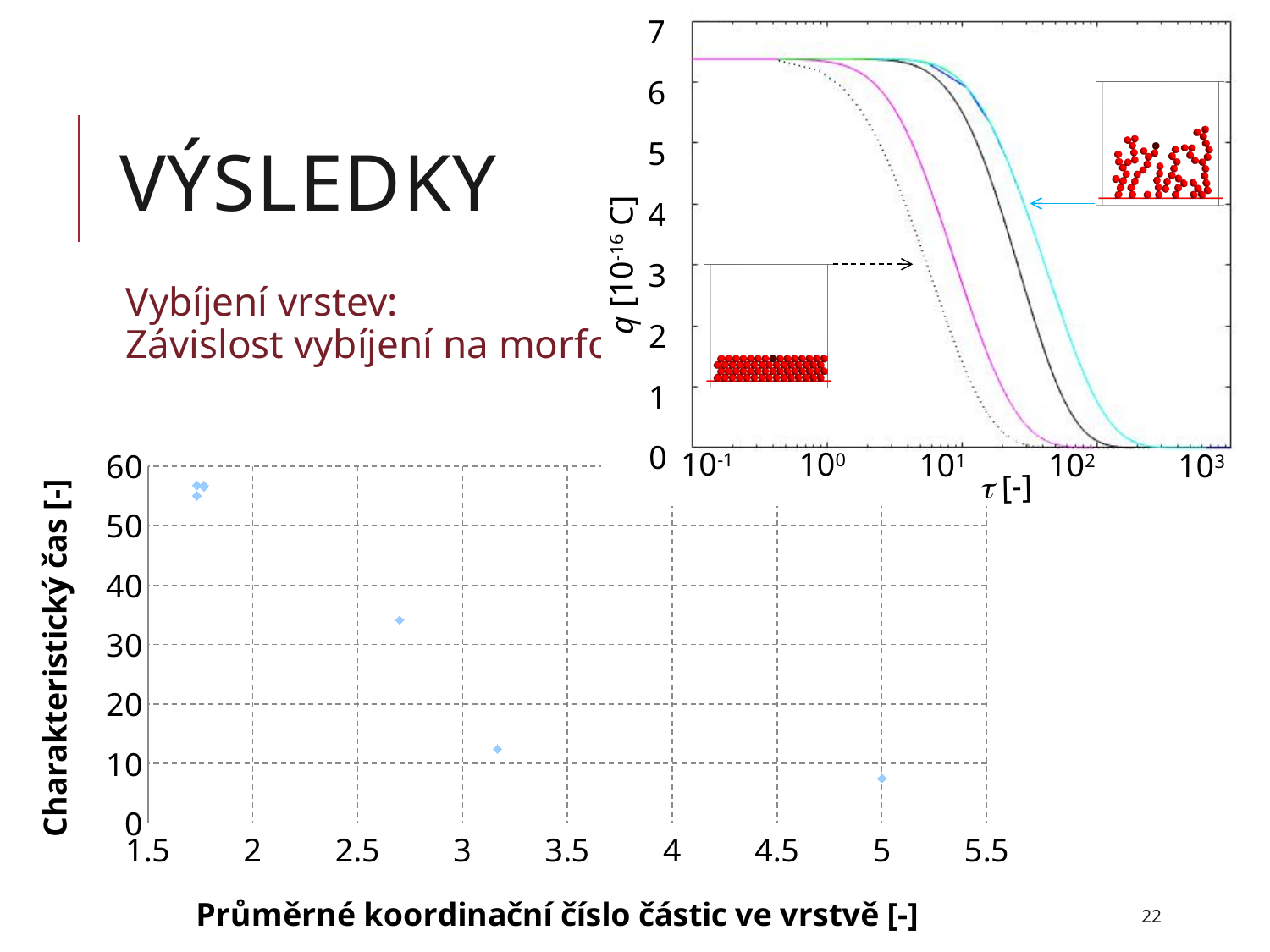
In the top-right line chart, do the curves rise or fall as τ increases? fall In the top-right line chart, is the value of the dotted curve at τ = 10^1 greater or less than 4? less In the bottom scatter chart, is the characteristic time for the point near coordination number 2.7 greater or less than 30? greater In the bottom scatter chart, is the characteristic time for the point at coordination number 5 greater or less than 10? less In the bottom scatter chart, does the characteristic time rise or fall as the average coordination number increases? fall What is the x-axis label of the bottom scatter chart? Průměrné koordinační číslo částic ve vrstvě [-] What kind of chart is the top-right chart (q vs τ)? line chart What kind of chart is the bottom chart (Charakteristický čas vs Průměrné koordinační číslo)? scatter chart In the bottom scatter chart, which has the larger characteristic time: the point near coordination number 2.7 or the point at coordination number 5? the point near 2.7 What is the y-axis label of the top-right line chart? q [10^-16 C]